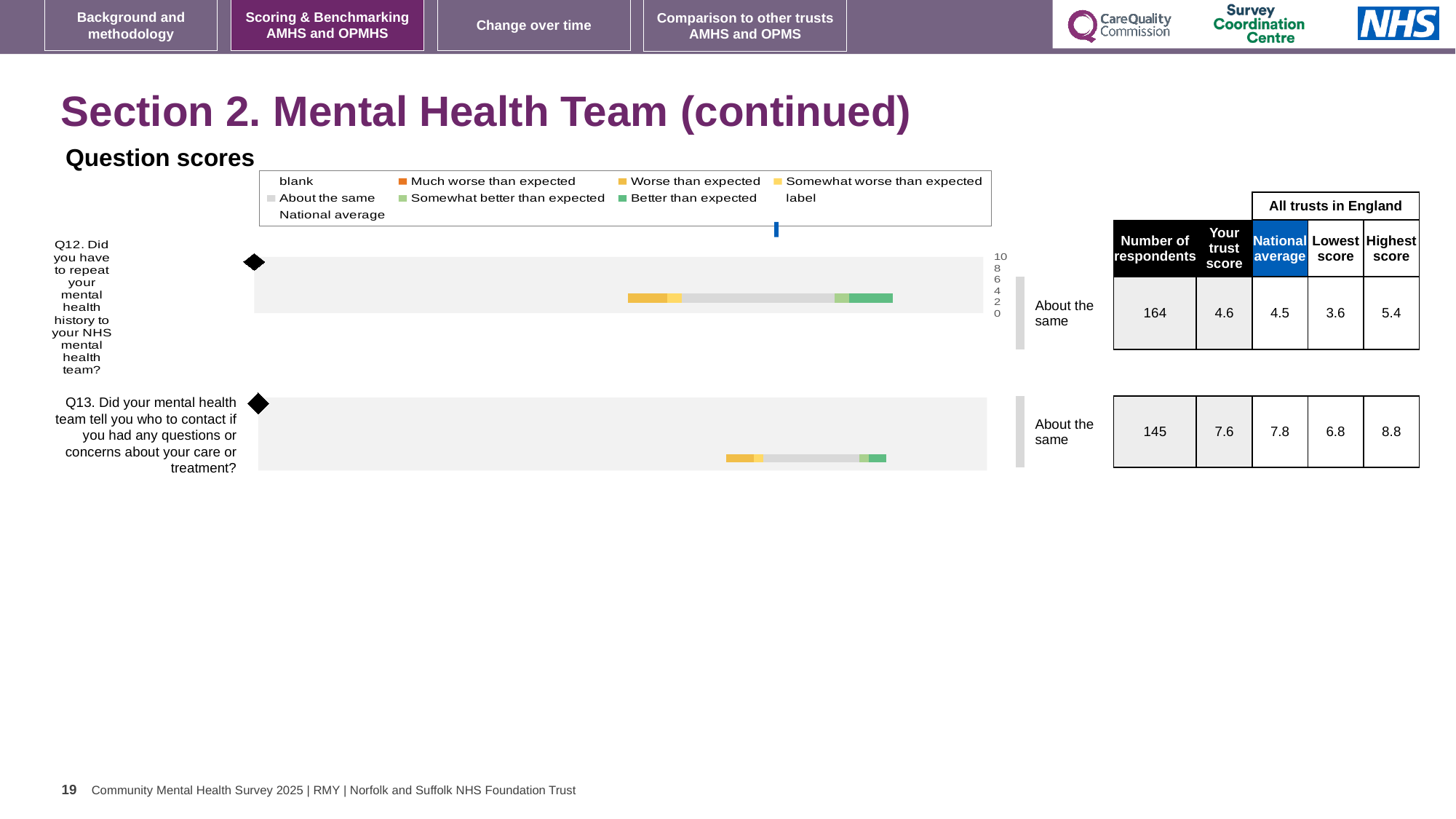
For Q13, what is the difference between the highest score and the lowest score among all trusts in England? 2.0 For Q12, what is the lowest score among all trusts in England? 3.6 What benchmark category label is shown next to the Q13 chart? About the same What benchmark category label is shown next to the Q12 chart? About the same Which question, Q12 or Q13, has the higher trust score? Q13 What kind of chart is used to show the question scores for Q12 and Q13? bar chart What is the highest value shown on the score axis of the Q12 chart? 10 For Q12, which is larger: the trust score or the national average? the trust score For Q12, how many respondents are shown in the table beside the chart? 164 How many questions are plotted in the question scores charts on this slide? 2 For Q13, what is the national average score? 7.8 For Q13, what is the trust's score shown in the table beside the chart? 7.6